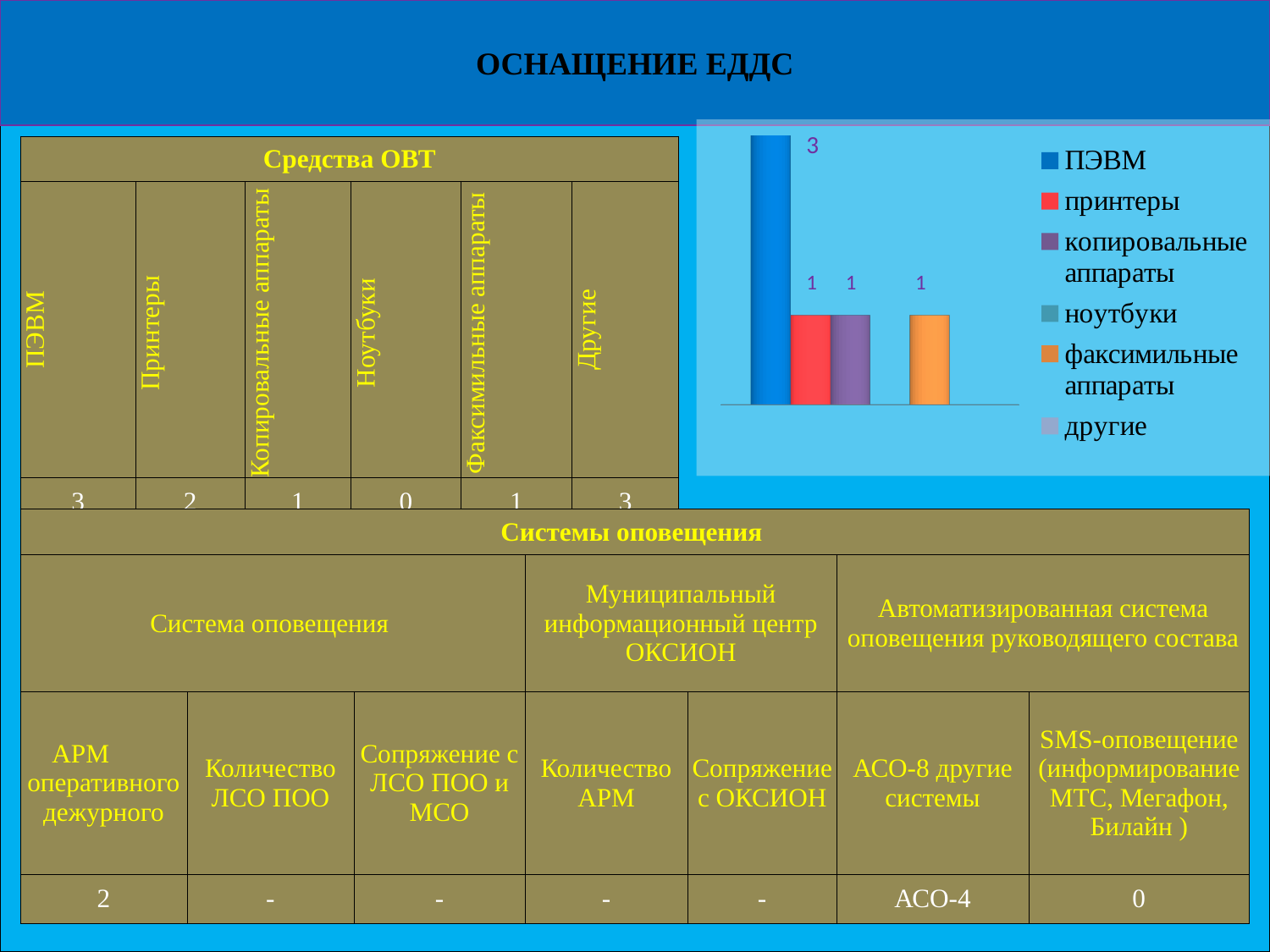
Which legend entry is listed first in the chart's legend? ПЭВМ What kind of chart is shown on the slide? bar chart What value does the chart show for ПЭВМ? 3 How many entries does the chart's legend list? 6 What value does the chart show for принтеры? 1 Which legend entry has the highest value in the chart? ПЭВМ What is the difference between the chart values for ПЭВМ and принтеры? 2 What value does the chart show for факсимильные аппараты? 1 What colour is the bar for ПЭВМ in the chart? blue Which is larger in the chart, the value for ПЭВМ or the value for факсимильные аппараты? ПЭВМ What value does the chart show for копировальные аппараты? 1